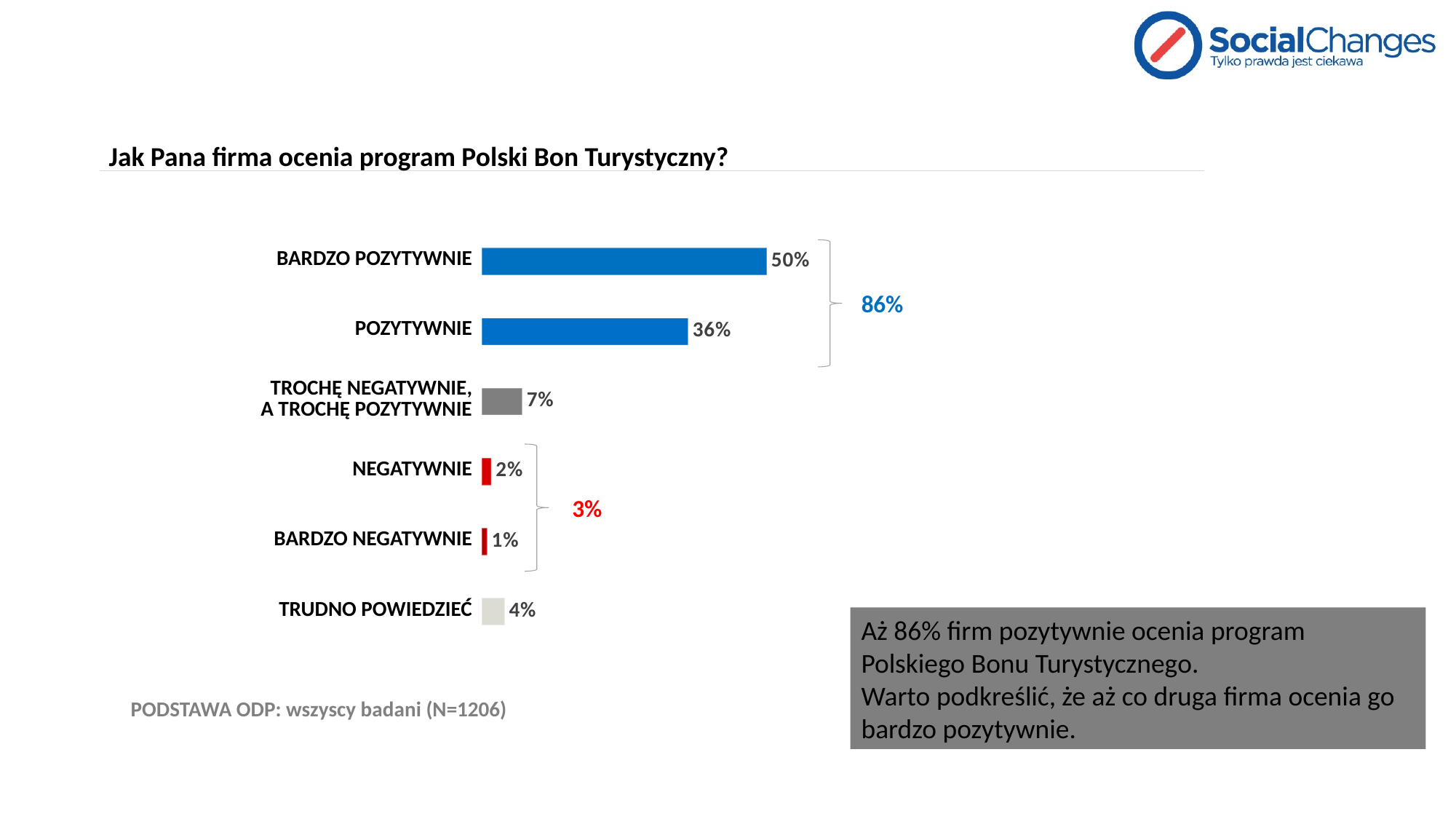
What combined percentage is shown by the bracket grouping "BARDZO POZYTYWNIE" and "POZYTYWNIE"? 86% What is the value for "TROCHĘ NEGATYWNIE, A TROCHĘ POZYTYWNIE"? 7% What is the difference between the values for "BARDZO POZYTYWNIE" and "POZYTYWNIE"? 14% What percentage of firms rated the program "BARDZO POZYTYWNIE"? 50% Which is larger, the value for "NEGATYWNIE" or for "TRUDNO POWIEDZIEĆ"? TRUDNO POWIEDZIEĆ How many categories are shown in the chart? 6 Which category has the highest value? BARDZO POZYTYWNIE What is the sample size stated at the bottom of the slide? N=1206 What is the value for "TRUDNO POWIEDZIEĆ"? 4% What kind of chart is shown on the slide? Bar chart Which category has the lowest value? BARDZO NEGATYWNIE What is the value for "POZYTYWNIE"? 36%